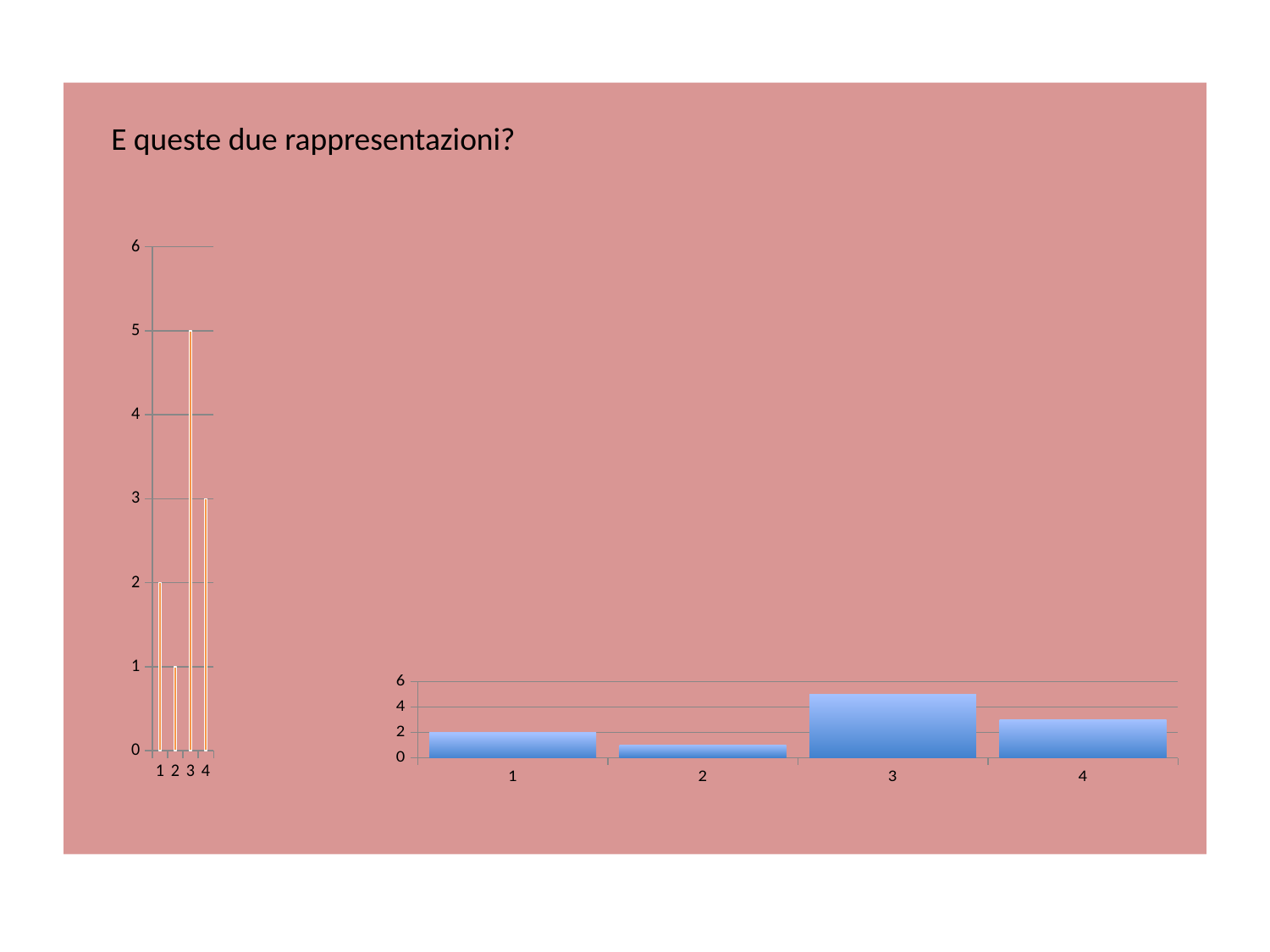
On the left chart, which category has the highest value? 3 On the left chart, which is larger, the value for category 1 or the value for category 4? category 4 On the right chart, is the value for category 2 greater or less than 2? less What kind of chart is the right chart? bar chart On the right chart, which category has the highest value? 3 On the right chart, what is the value for category 1? 2 How many categories are shown on the right chart? 4 On the left chart, which category has the lowest value? 2 On the left chart, what is the difference between the values for category 3 and category 4? 2 On the right chart, is the value for category 3 greater or less than 4? greater On the left chart, what is the value for category 3? 5 On the left chart, what is the value for category 1? 2